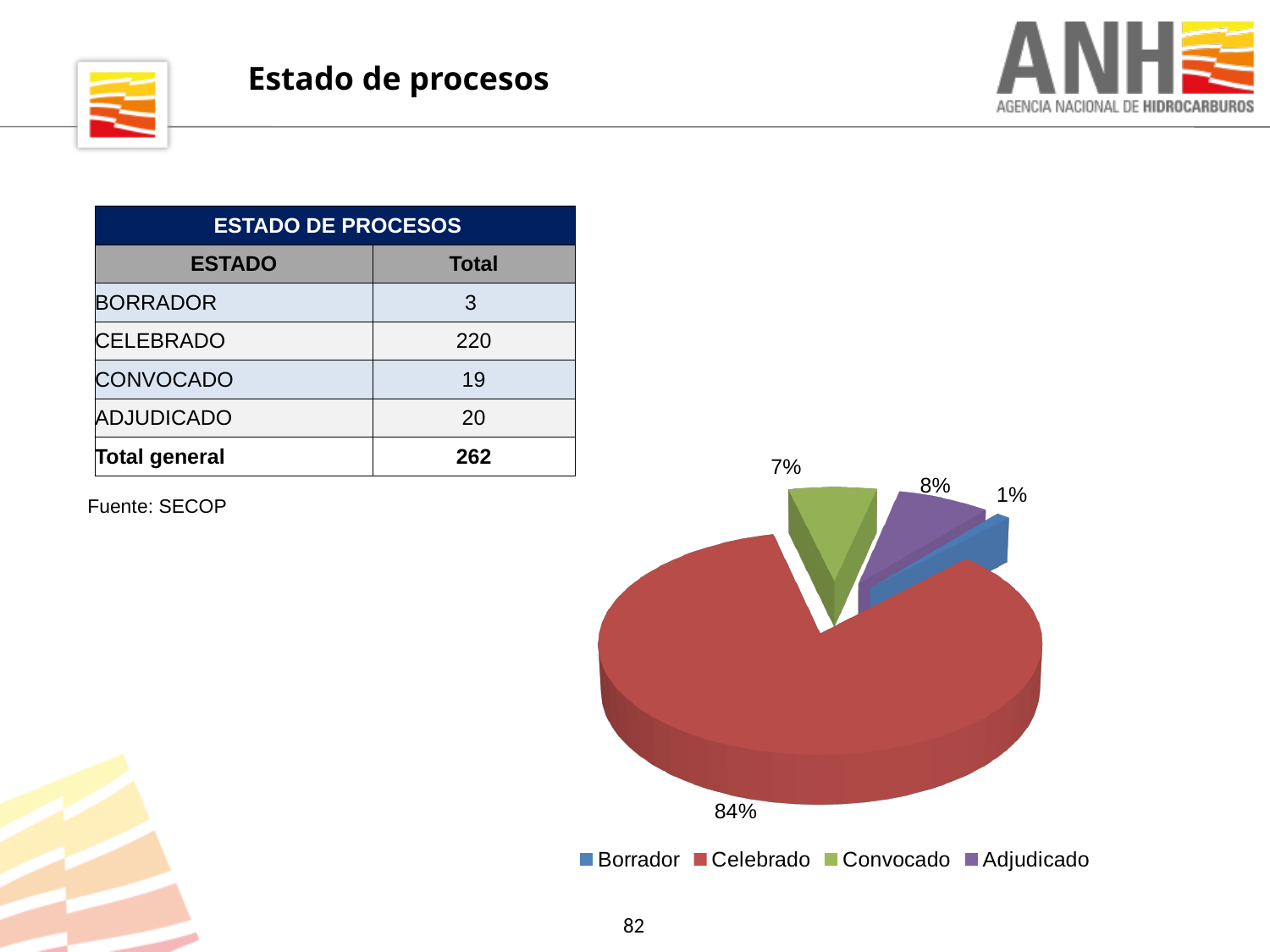
Which category has the smallest slice in the pie chart? Borrador How many entries does the pie chart legend list? 4 What colour is the Celebrado slice in the pie chart? red What percentage of the pie chart does Adjudicado represent? 8% How many slices does the pie chart have? 4 What is the difference in percentage points between the Celebrado slice and the Convocado slice? 77% Which category has the largest slice in the pie chart? Celebrado What kind of chart is shown on the slide? pie chart What percentage of the pie chart does Convocado represent? 7% What percentage of the pie chart does Borrador represent? 1% Which slice is larger in the pie chart, Adjudicado or Convocado? Adjudicado